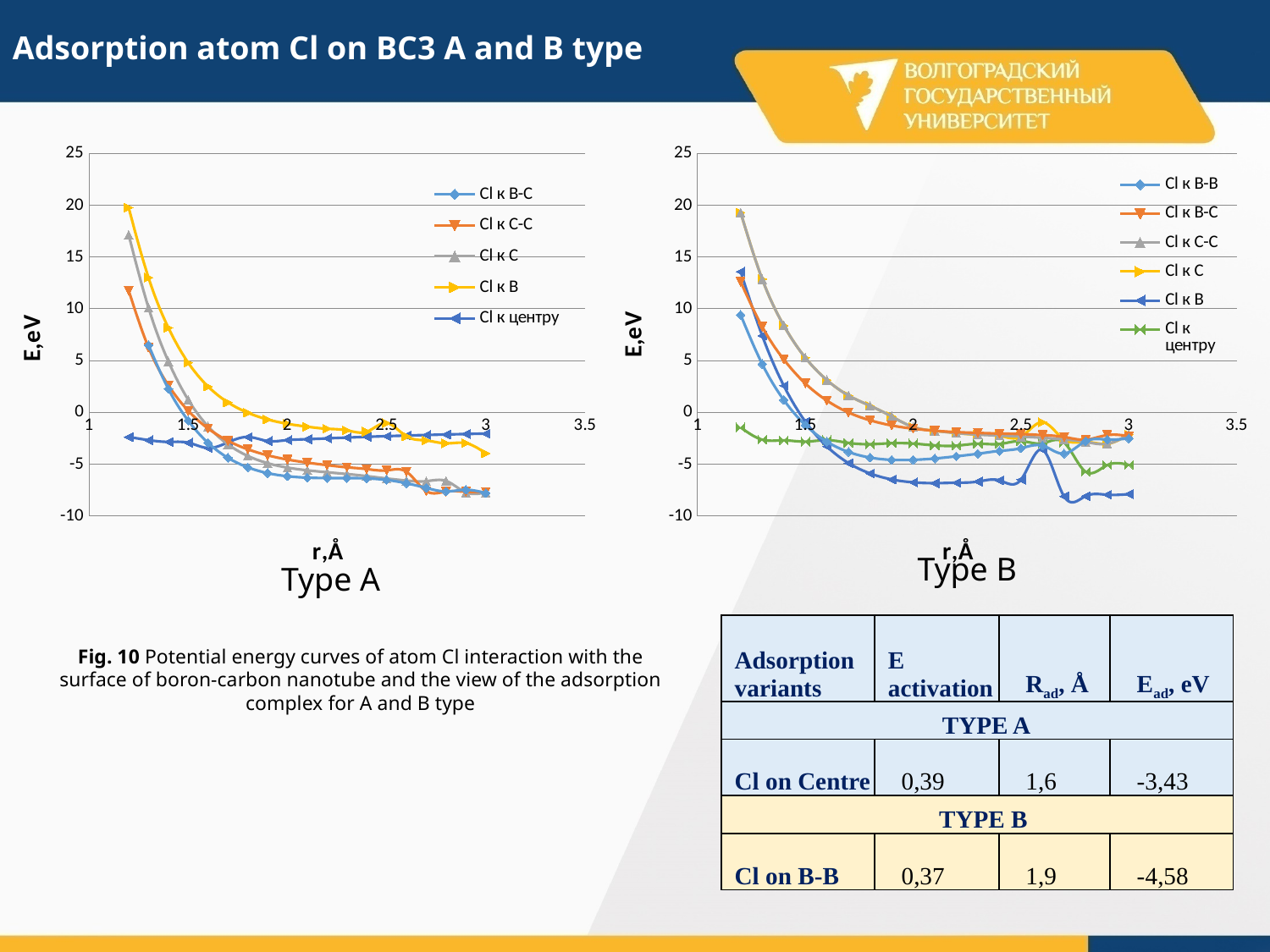
In the Type A chart, is the value of the Cl к B series at r = 1.2 greater or less than 15? greater In the Type B chart, which series reaches the lowest value on the chart? Cl к B In the Type B chart, is the value of the Cl к B series at r = 3 greater or less than -5? less In the Type B chart, does the Cl к C-C series rise or fall as r increases from 1.2 to 2.5? fall How many series does the legend of the Type B chart list? 6 In the Type A chart, is the value of the Cl к центру series at r = 1.5 greater or less than 0? less What is the title of the vertical axis on the Type B chart? E,eV How many series does the legend of the Type A chart list? 5 In the Type A chart, which series has the larger value at r = 1.2: Cl к B or Cl к C-C? Cl к B What kind of chart is the Type A chart? line chart In the Type A chart, does the Cl к B-C series rise or fall as r increases from 1.3 to 3? fall